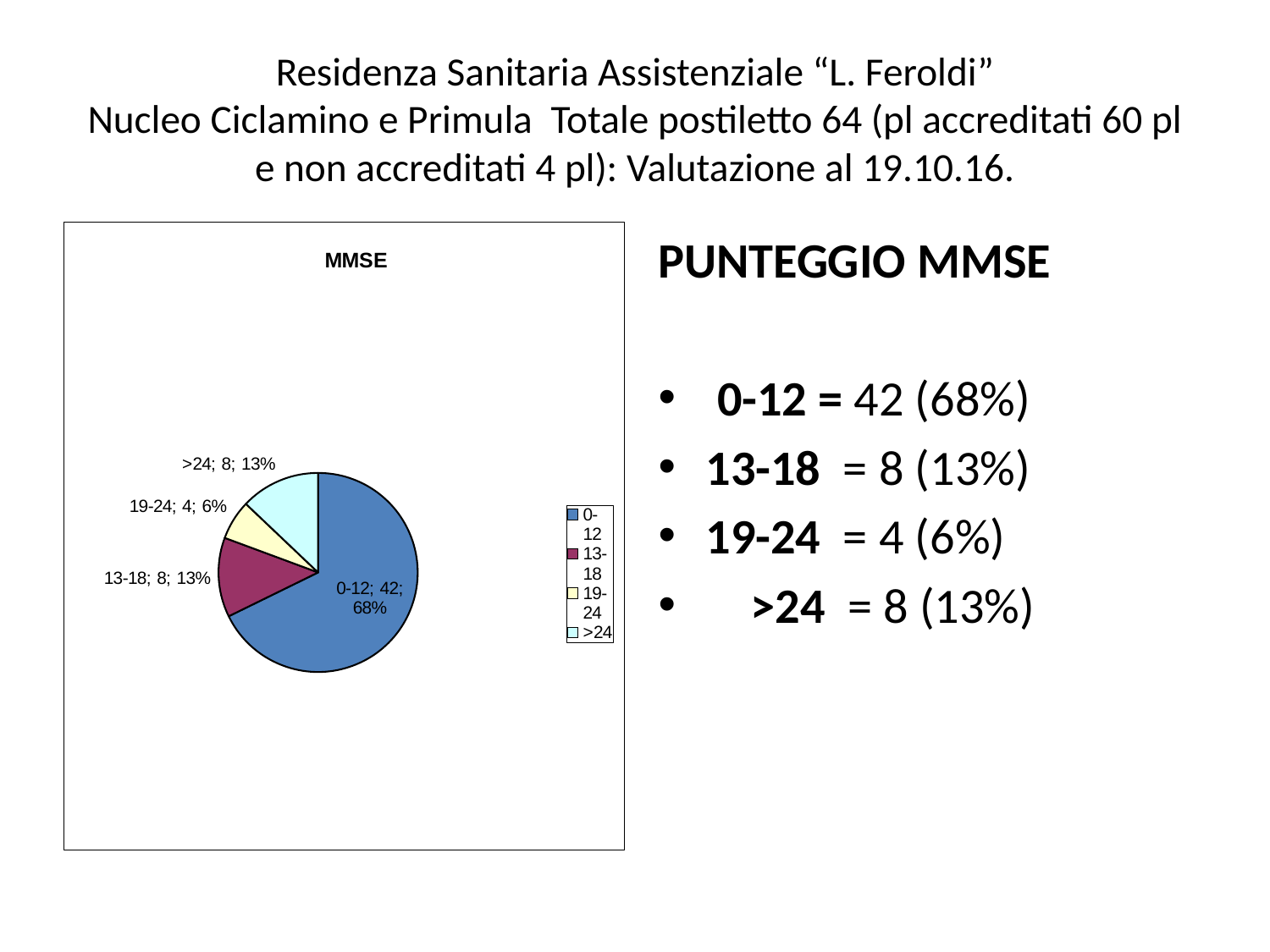
Which category has the largest slice? 0-12 What is the title of the chart? MMSE What is the value for the 19-24 slice? 4 What share of the pie does the 0-12 slice represent? 68% What is the value for the 13-18 slice? 8 What is the difference between the values for 0-12 and >24? 34 How many entries does the legend list? 4 What is the value for the 0-12 slice? 42 What kind of chart is shown on the slide? pie chart How many slices does the pie chart have? 4 What share of the pie does the 19-24 slice represent? 6% Which category has the smallest slice? 19-24